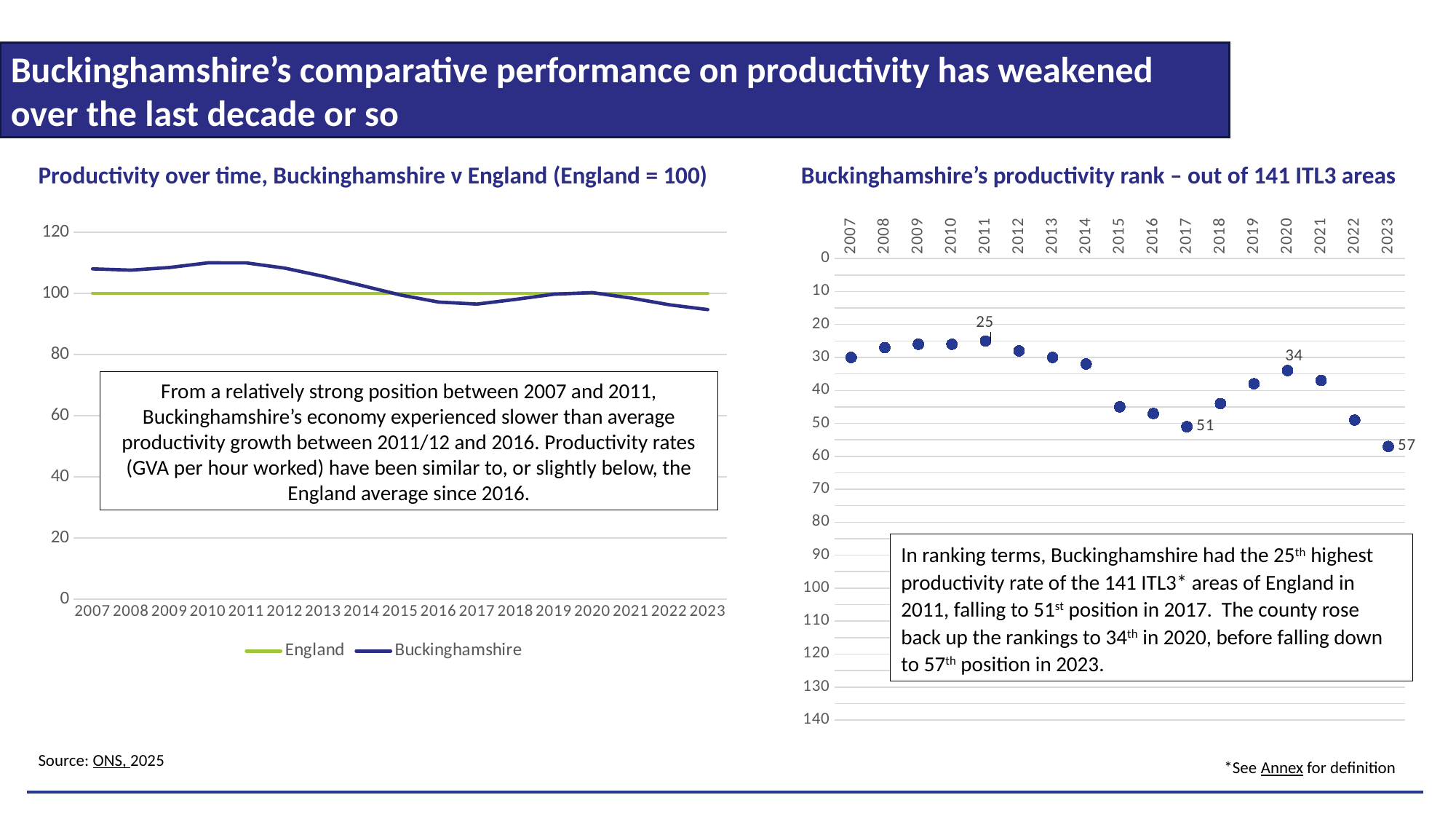
In the left chart, is the Buckinghamshire value for 2023 greater or less than 100? less In the right chart, by how many places did Buckinghamshire's rank number change between 2011 (25) and 2023 (57)? 32 What kind of chart is the left chart, 'Productivity over time, Buckinghamshire v England'? Line chart In the right chart, what was Buckinghamshire's productivity rank in 2017? 51 In the left chart, does the Buckinghamshire line overall rise or fall between 2011 and 2023? Fall In the left chart, is the Buckinghamshire value for 2010 greater or less than 100? greater In the right chart, 'Buckinghamshire's productivity rank', what was Buckinghamshire's rank in 2011? 25 In the left chart, which series has the larger value in 2010, England or Buckinghamshire? Buckinghamshire In the right chart, what was Buckinghamshire's productivity rank in 2023? 57 In the right chart, which year has the highest rank number (worst rank) shown? 2023 How many years are shown on the x axis of the left chart? 17 How many series does the legend of the left chart list? 2